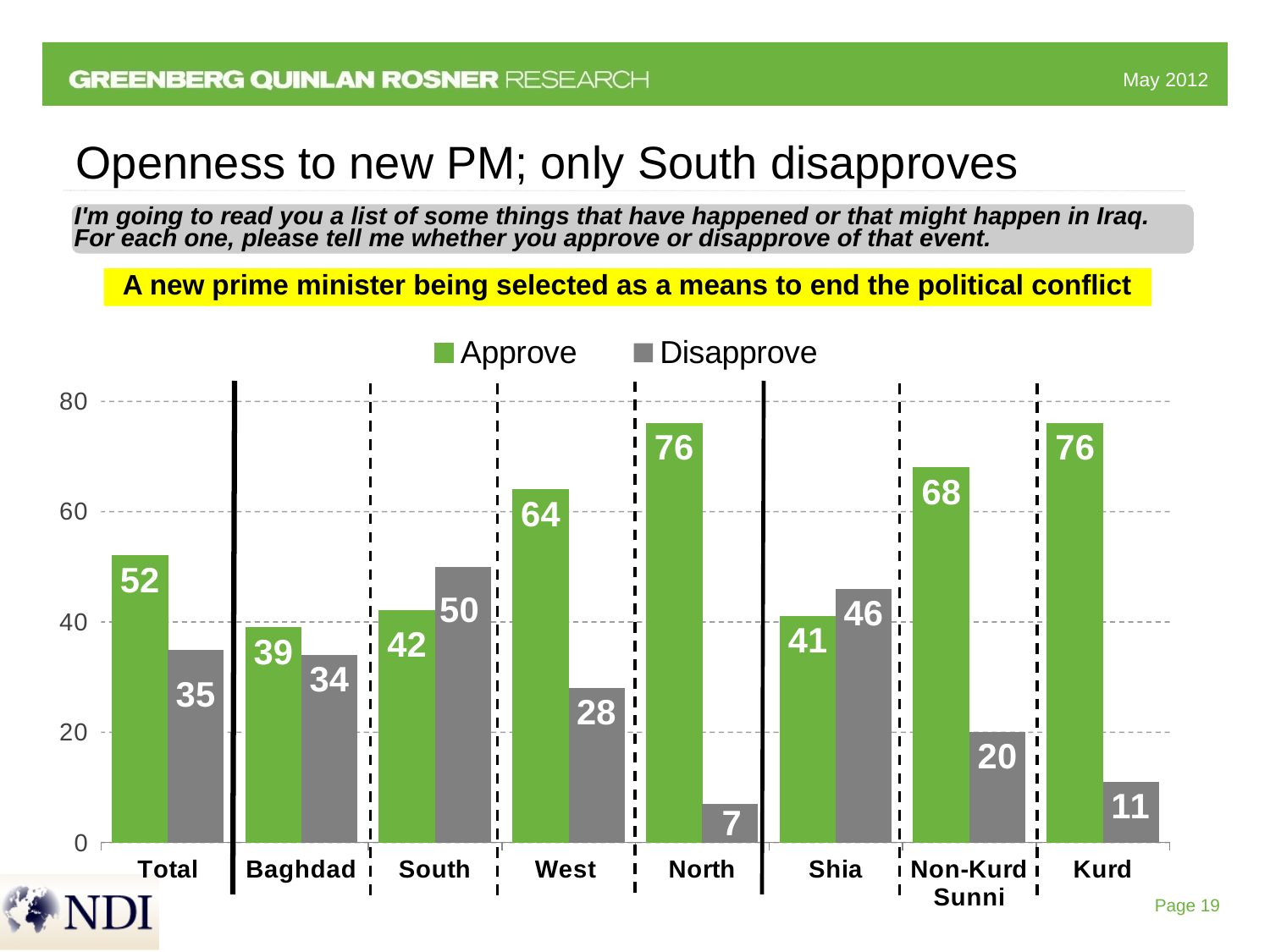
What is the difference between the Approve and Disapprove values for the West? 36 Which category has the lowest Disapprove value? North What is the Approve value for the South? 42 How many series does the legend list? 2 What is the Approve value for Total? 52 Which is larger for Shia: the Approve value or the Disapprove value? Disapprove What is the Disapprove value for Non-Kurd Sunni? 20 What kind of chart is shown on the slide? bar chart Which colour represents the Disapprove series? grey Which category has the lowest Approve value? Baghdad How many categories are shown on the x axis? 8 Is the Approve value for Kurd greater or less than 60? greater